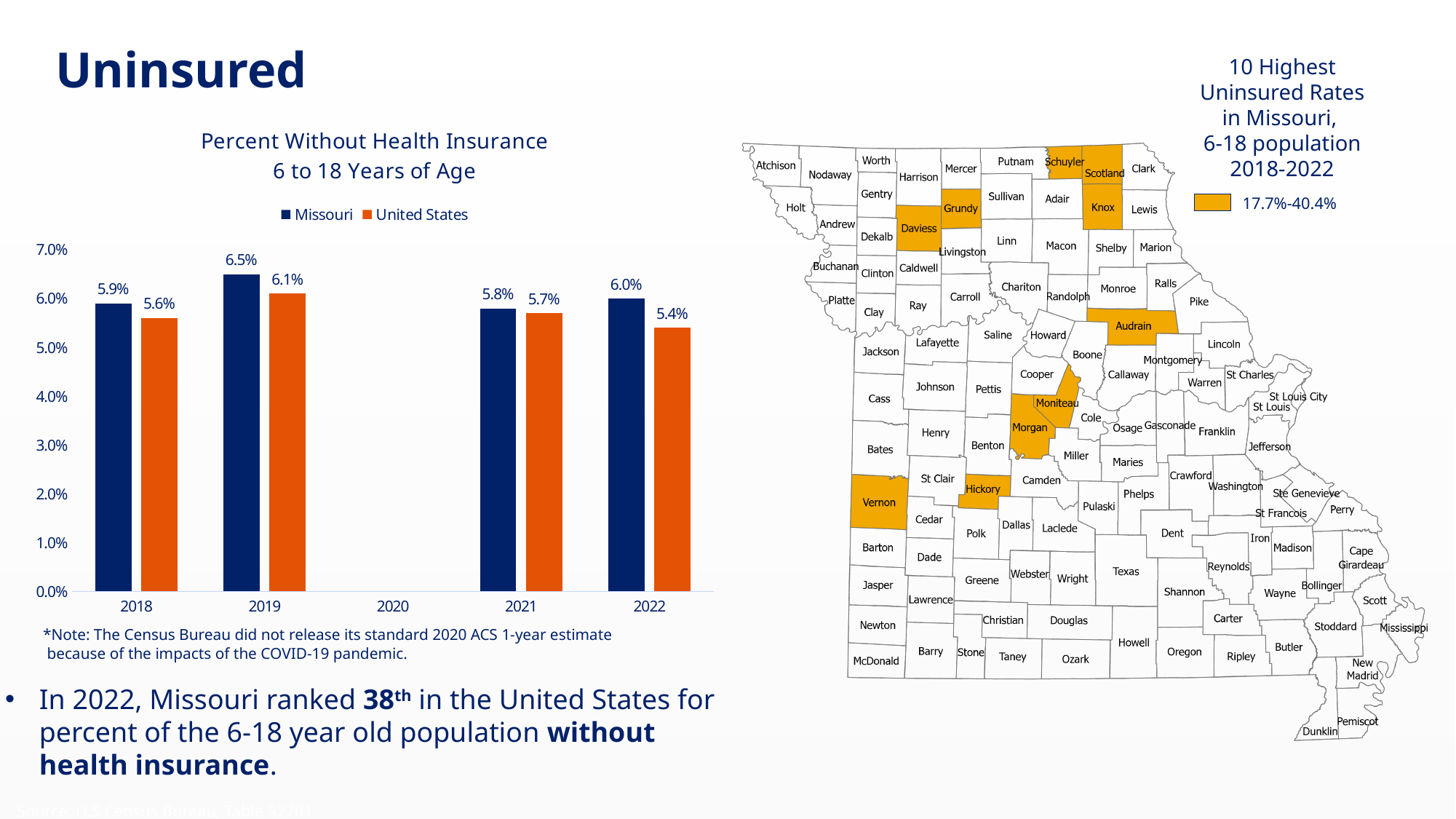
How many series does the legend of the bar chart list? 2 What type of chart is 'Percent Without Health Insurance 6 to 18 Years of Age'? Bar chart Is the Missouri value for 2019 greater or less than 6.0% in the bar chart? greater In which year is the United States value lowest in the bar chart? 2022 In 2018, which is larger in the bar chart: Missouri or United States? Missouri What is the United States value for 2022 in the bar chart? 5.4% What is the difference between the Missouri and United States values for 2022 in the bar chart? 0.6% What is the Missouri value for 2021 in the bar chart? 5.8% What is the Missouri value for 2019 in the bar chart? 6.5% What range does the legend of the Missouri map give for the highlighted counties? 17.7%-40.4% Which year on the x axis of the bar chart has no bars plotted? 2020 In which year is the Missouri value highest in the bar chart? 2019